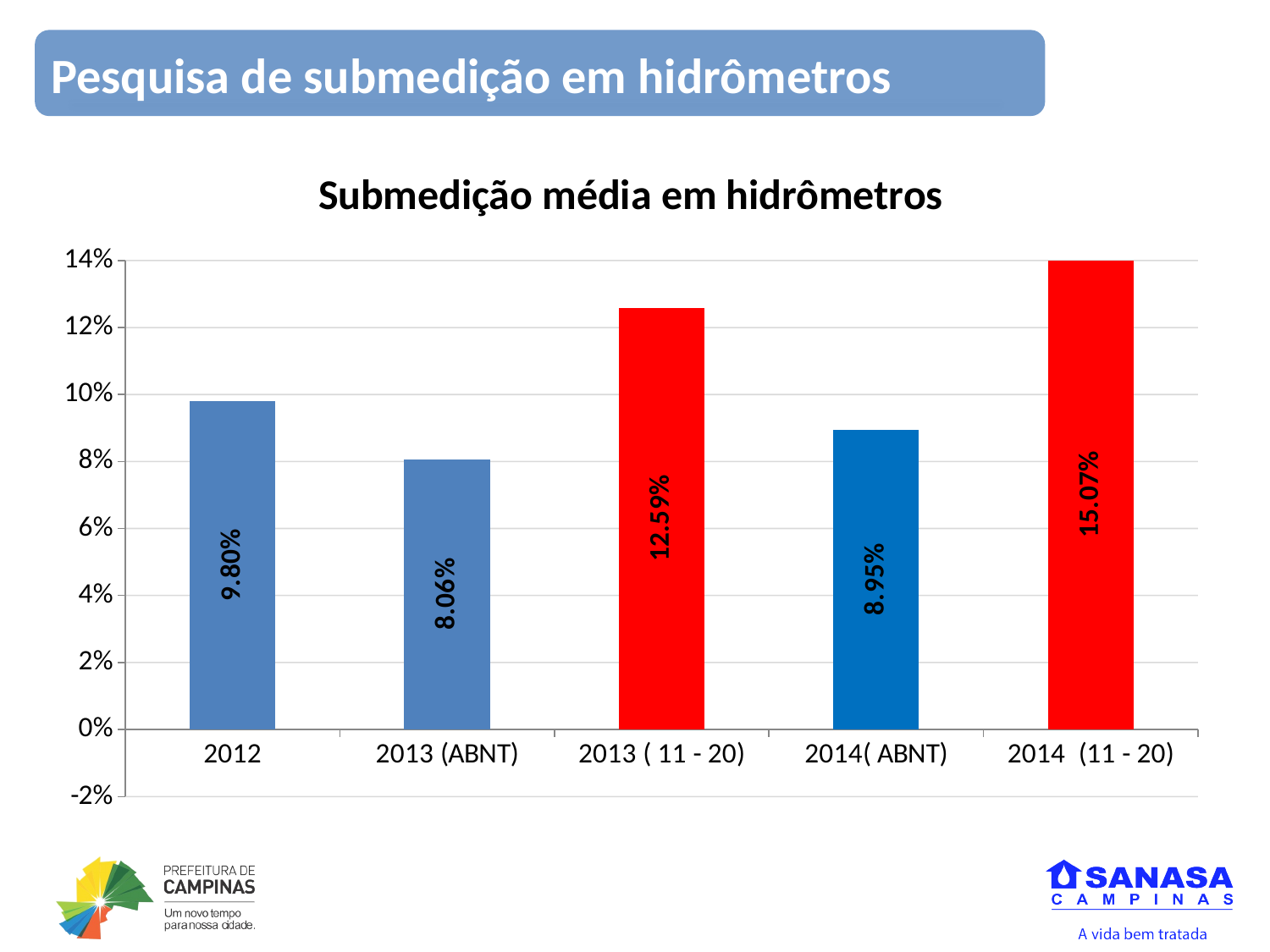
Which is larger, the value for 2012 or the value for 2014( ABNT)? 2012 What is the value for 2013 (ABNT)? 8.06% What is the value for 2014( ABNT)? 8.95% What kind of chart is shown on the slide? Bar chart What is the value for 2012? 9.80% What is the value for 2014 (11 - 20)? 15.07% What is the title of the chart? Submedição média em hidrômetros Which category has the highest value? 2014 (11 - 20) What is the value for 2013 ( 11 - 20)? 12.59% What is the difference between the values for 2014 (11 - 20) and 2013 ( 11 - 20)? 2.48% Which category has the lowest value? 2013 (ABNT) How many categories are shown on the x axis? 5